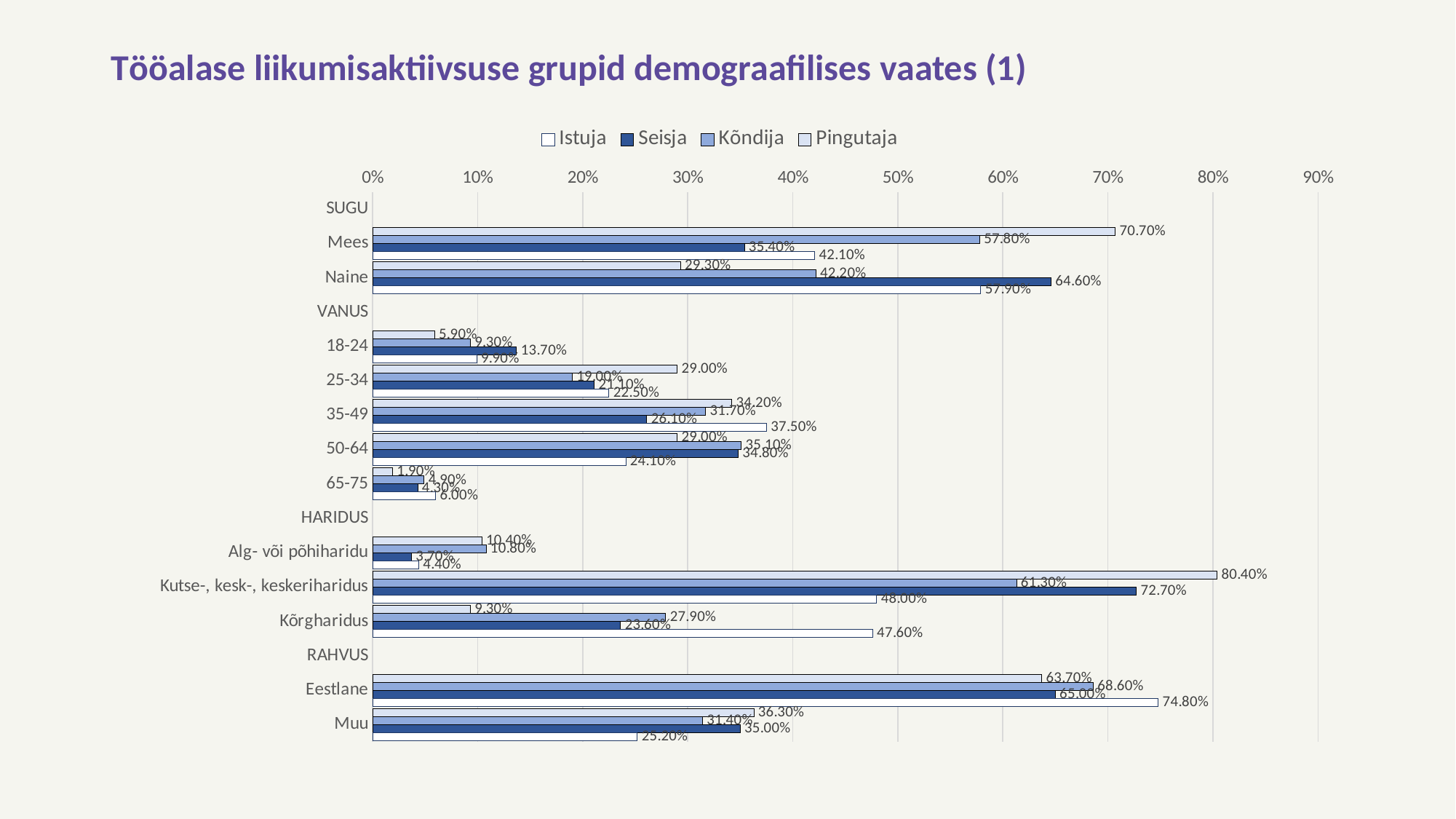
Which is larger, the Istuja value for Eestlane or the Istuja value for Muu? Eestlane What is the Seisja value for Naine? 64.60% What is the Istuja value for Kõrgharidus? 47.60% Which series is shown with the darkest blue bars? Seisja What is the Pingutaja value for Mees? 70.70% What is the Istuja value for Eestlane? 74.80% What kind of chart is shown on the slide? Bar chart How many series does the legend list? 4 Which category has the highest Pingutaja value? Kutse-, kesk-, keskeriharidus What is the difference between the Pingutaja values for Mees and Naine? 41.40% What is the Seisja value for the 18-24 age group? 13.70% Is the Istuja value for Kutse-, kesk-, keskeriharidus greater or less than 40%? greater